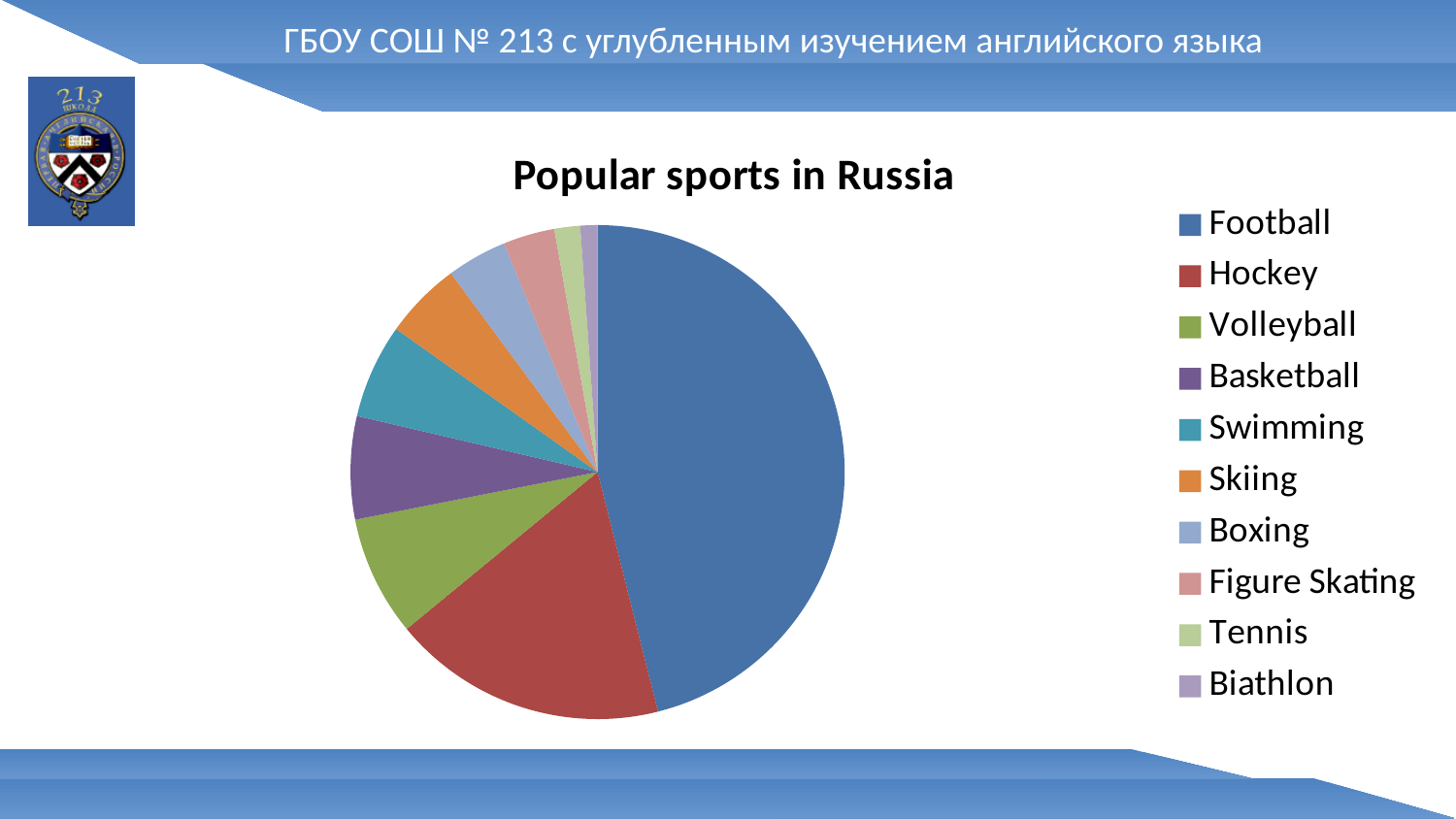
What is the title of the chart? Popular sports in Russia What kind of chart is shown on the slide? pie chart Which slice is larger, Football or Hockey? Football Which sport has the second-largest slice of the pie? Hockey Which slice is larger, Swimming or Tennis? Swimming Which sport has the largest slice of the pie? Football How many sports (slices) does the pie chart show? 10 Which sport is listed last in the legend? Biathlon